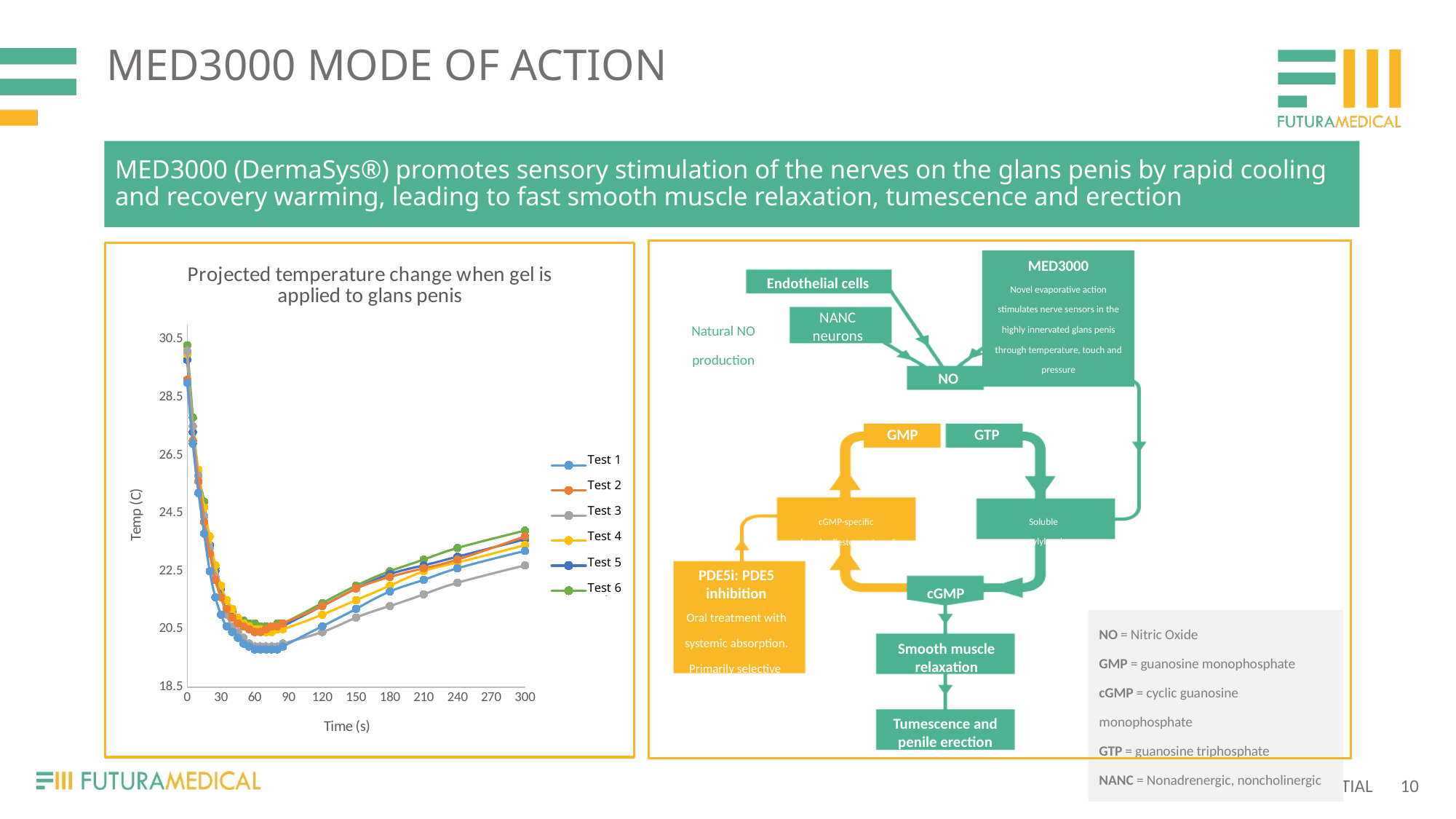
Does the temperature rise or fall between 120 s and 300 s in the chart? rise What is the label of the chart's x axis? Time (s) How many series does the chart's legend list? 6 Is the lowest temperature reached by Test 1 greater or less than 20.5? less Is the starting temperature at 0 s greater or less than 28.5? greater Which test series has the lowest temperature at 300 s? Test 3 At 300 s, is the temperature for Test 3 or Test 6 higher? Test 6 Which test series reaches the lowest temperature in the chart? Test 1 Is the temperature for Test 3 at 300 s greater or less than 24.5? less What is the title of the chart? Projected temperature change when gel is applied to glans penis What kind of chart is shown on the slide? line chart Does the temperature rise or fall over the first 60 seconds in the chart? fall